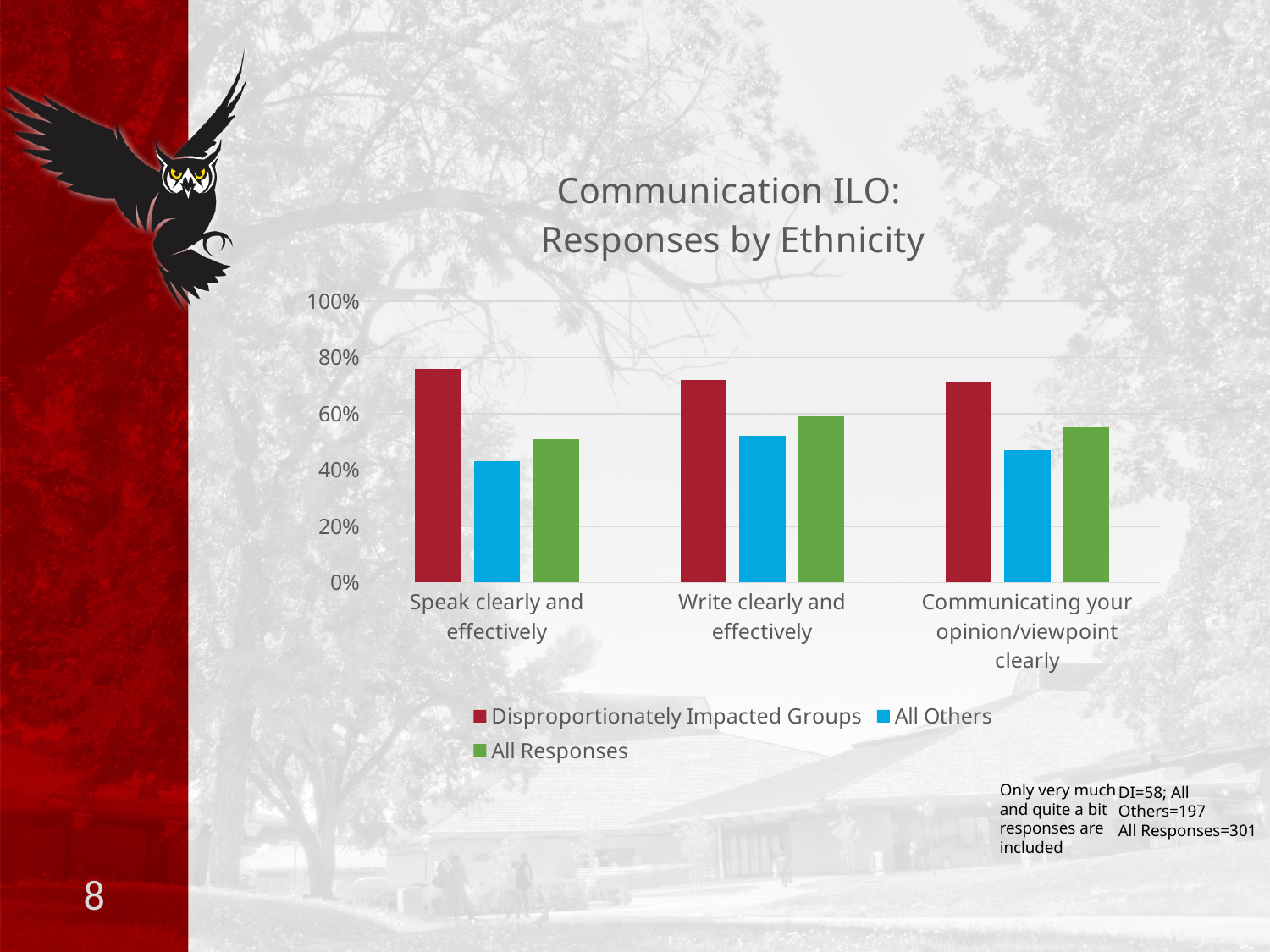
How many categories are shown on the x axis? 3 Is the value for Disproportionately Impacted Groups on "Speak clearly and effectively" greater or less than 60%? greater Which series has the lowest value for "Write clearly and effectively"? All Others Which is larger: the All Others value for "Speak clearly and effectively" or for "Write clearly and effectively"? Write clearly and effectively What kind of chart is shown on the slide? bar chart Is the value for All Others on "Speak clearly and effectively" greater or less than 60%? less What is the title of the chart? Communication ILO: Responses by Ethnicity Is the value for Disproportionately Impacted Groups on "Communicating your opinion/viewpoint clearly" greater or less than 60%? greater How many series does the legend list? 3 Which series has the highest value for "Speak clearly and effectively"? Disproportionately Impacted Groups Which colour represents the All Responses series in the legend? green